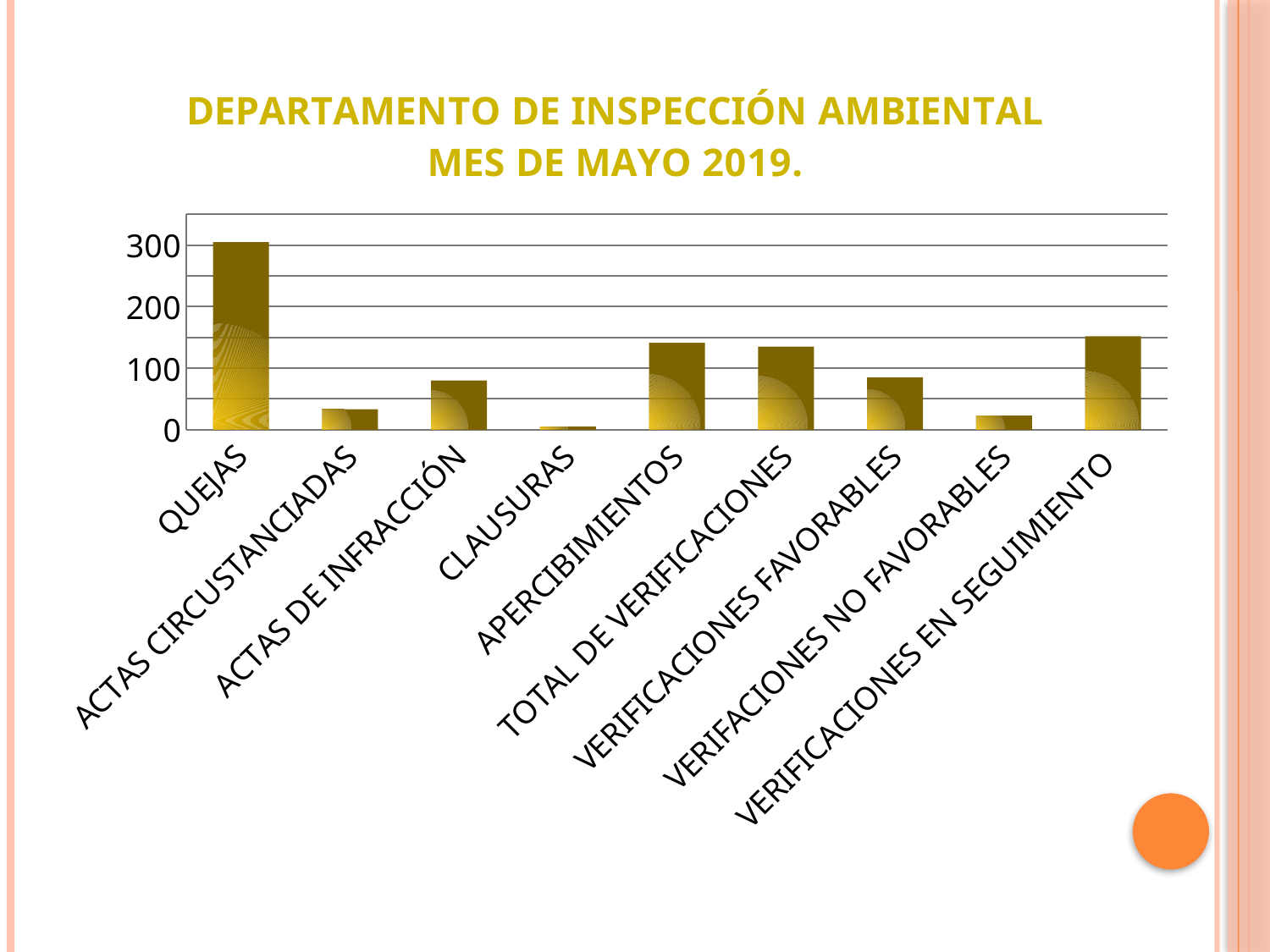
Is the value for VERIFICACIONES NO FAVORABLES greater or less than 100? less How many categories are shown on the x axis of the chart? 9 What kind of chart is shown on the slide? Bar chart Which category has the highest bar in the chart? QUEJAS Which is larger, the value for QUEJAS or the value for ACTAS CIRCUSTANCIADAS? QUEJAS Is the value for ACTAS CIRCUSTANCIADAS greater or less than 100? less Is the value for APERCIBIMIENTOS greater or less than 100? greater Which category has the lowest bar in the chart? CLAUSURAS What is the title of the slide above the chart? DEPARTAMENTO DE INSPECCIÓN AMBIENTAL MES DE MAYO 2019. Which is larger, the value for VERIFICACIONES EN SEGUIMIENTO or the value for VERIFICACIONES FAVORABLES? VERIFICACIONES EN SEGUIMIENTO